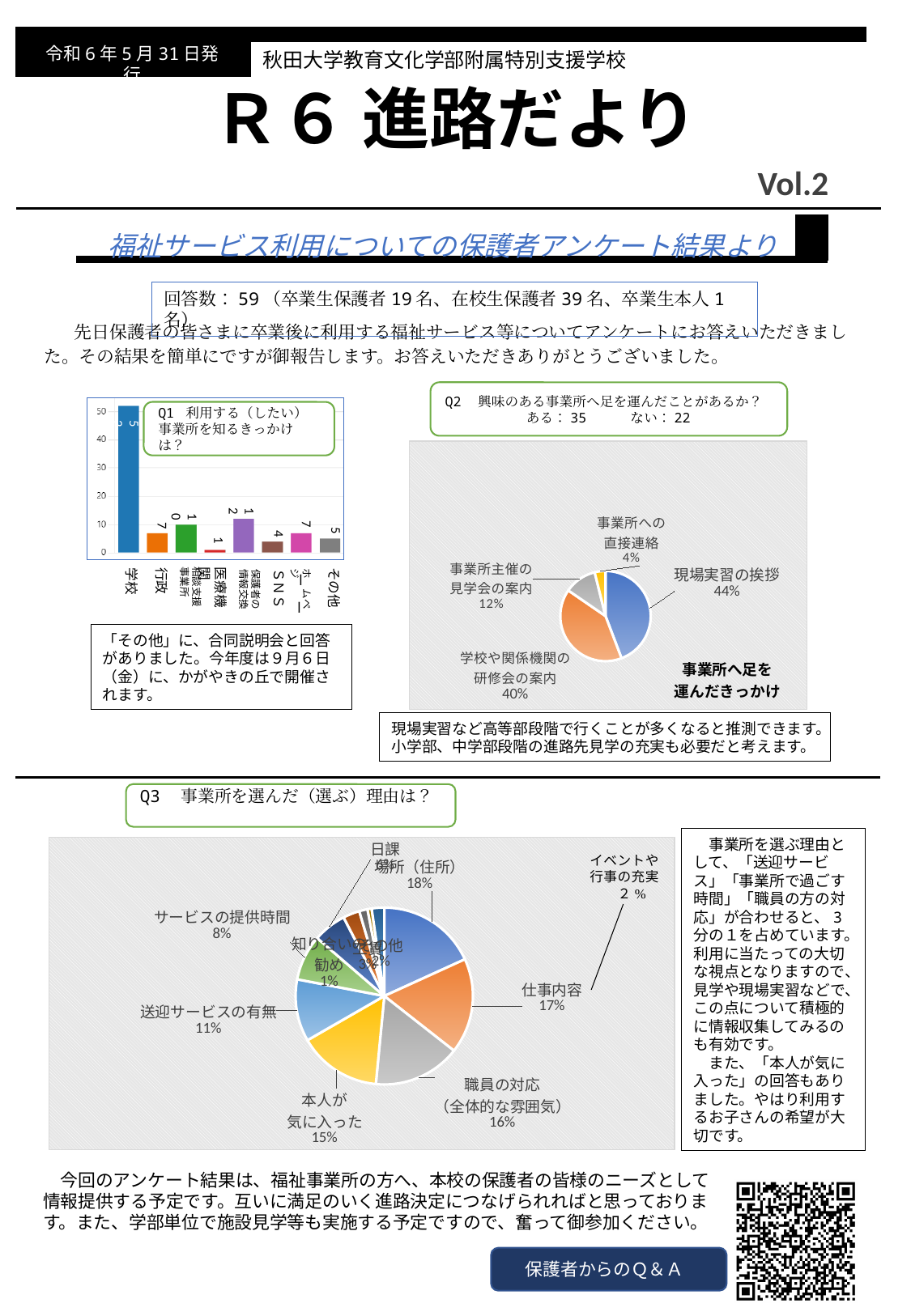
In the Q1 bar chart, what is the difference between the values for 医療機関 and SNS? 3 How many slices does the Q2 pie chart have? 4 In the Q1 bar chart, which category has the lowest value? 医療機関 In the Q2 pie chart (事業所へ足を運んだきっかけ), what share is 現場実習の挨拶? 44% In the Q1 bar chart, which category has the highest value? 学校 In the Q2 pie chart, which category has the smallest share? 事業所への直接連絡 In the Q1 bar chart, is the value for 学校 greater or less than 40? greater In the Q1 bar chart (利用する（したい）事業所を知るきっかけは？), what is the value for 行政? 7 In the Q1 bar chart, what is the value for 保護者の情報交換? 12 In the Q3 pie chart (事業所を選んだ（選ぶ）理由は？), what share is 送迎サービスの有無? 11% What kind of chart is the Q1 chart? bar chart In the Q3 pie chart, which is larger, 場所（住所） or 仕事内容? 場所（住所）